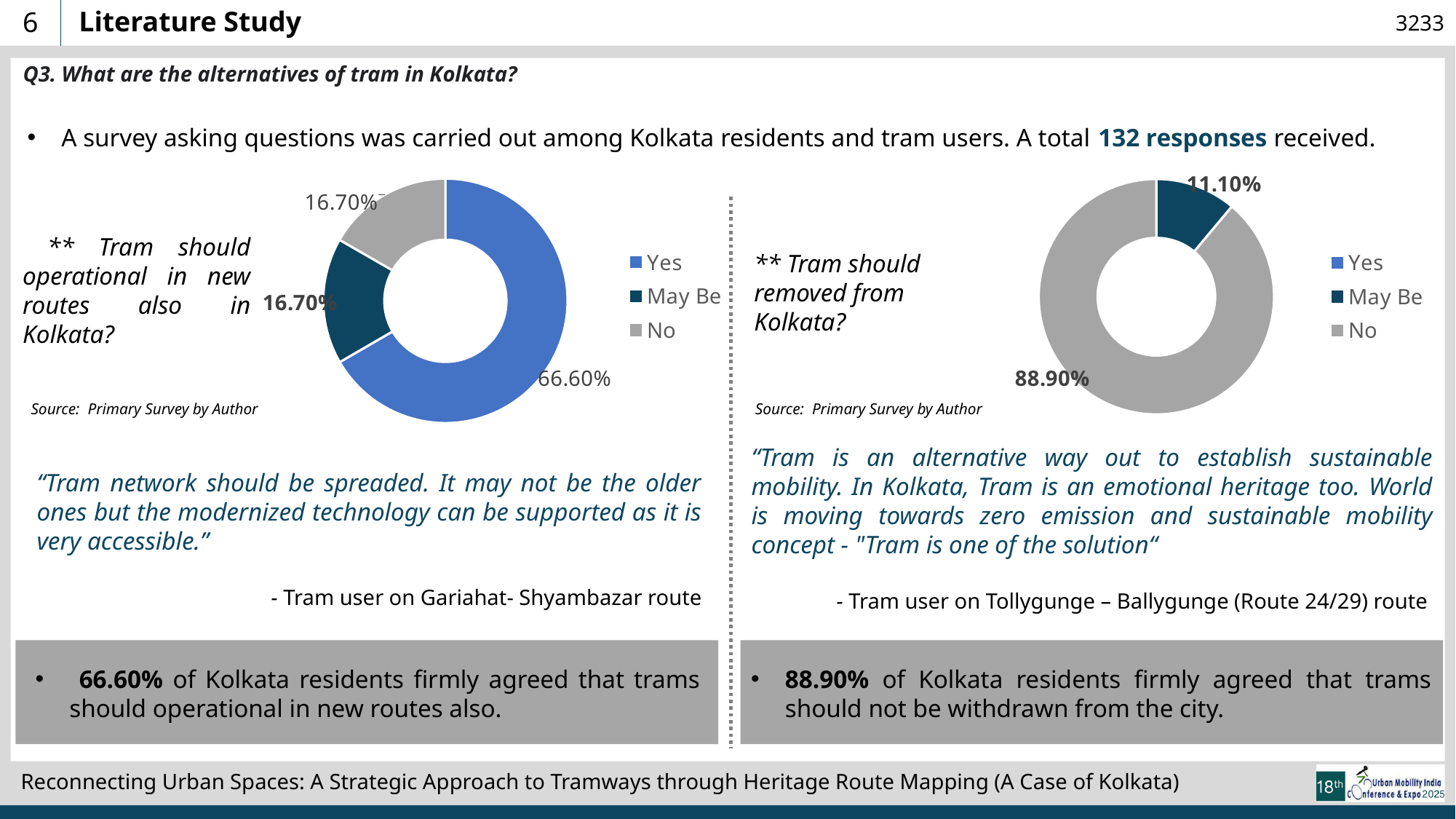
In the right donut chart (Tram should removed from Kolkata?), what is the smaller percentage value printed on the chart? 11.10% In the right donut chart (Tram should removed from Kolkata?), which response has the largest share? No In the left donut chart (Tram should operational in new routes also in Kolkata?), what percentage answered May Be? 16.70% In the left donut chart (Tram should operational in new routes also in Kolkata?), which response has the largest share? Yes In the left donut chart (Tram should operational in new routes also in Kolkata?), what percentage answered Yes? 66.60% In the left donut chart (Tram should operational in new routes also in Kolkata?), what percentage answered No? 16.70% How many entries does the legend of the left donut chart list? 3 In the left donut chart (Tram should operational in new routes also in Kolkata?), what is the difference between the Yes share and the No share? 49.90% What type of chart is used on the right side of the slide for the question 'Tram should removed from Kolkata?' Donut (pie) chart In the right donut chart (Tram should removed from Kolkata?), what is the difference between the two printed percentage values? 77.80% In the legend of the right donut chart, which colour represents the No response? Gray In the right donut chart (Tram should removed from Kolkata?), what percentage answered No? 88.90%